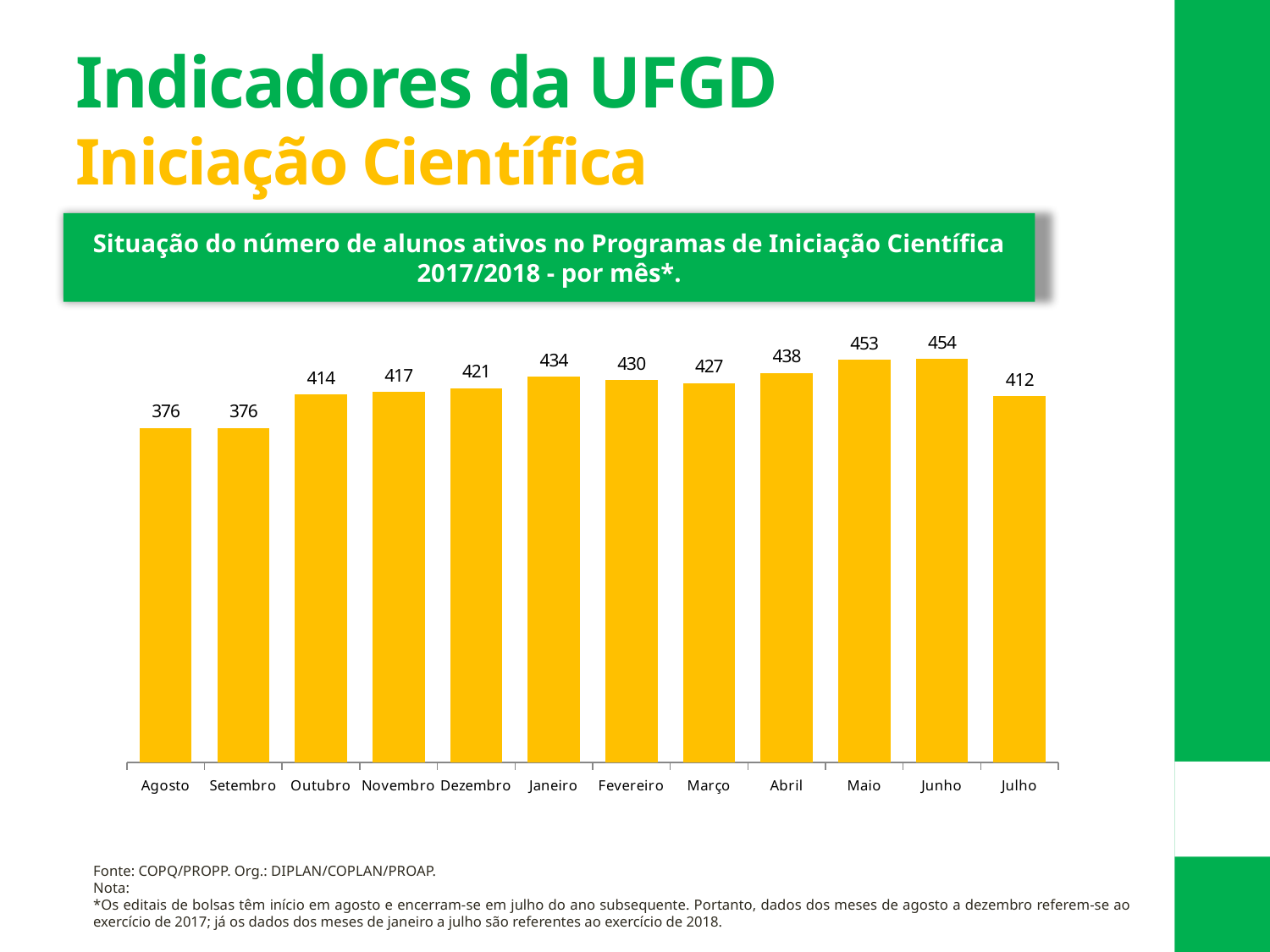
What is the difference between the values for Abril and Março? 11 What is the lowest value shown on the chart? 376 Which is larger, the value for Fevereiro or the value for Março? Fevereiro What colour are the bars in the chart? Yellow Which month has the highest number of active students? Junho What is the value shown for Julho? 412 What is the number of active students in Outubro? 414 What is the value shown for Janeiro? 434 Do the values rise or fall from Agosto to Dezembro? Rise How many months are shown on the x axis? 12 What is the difference between the values for Junho and Agosto? 78 What kind of chart is shown on the slide? Bar chart